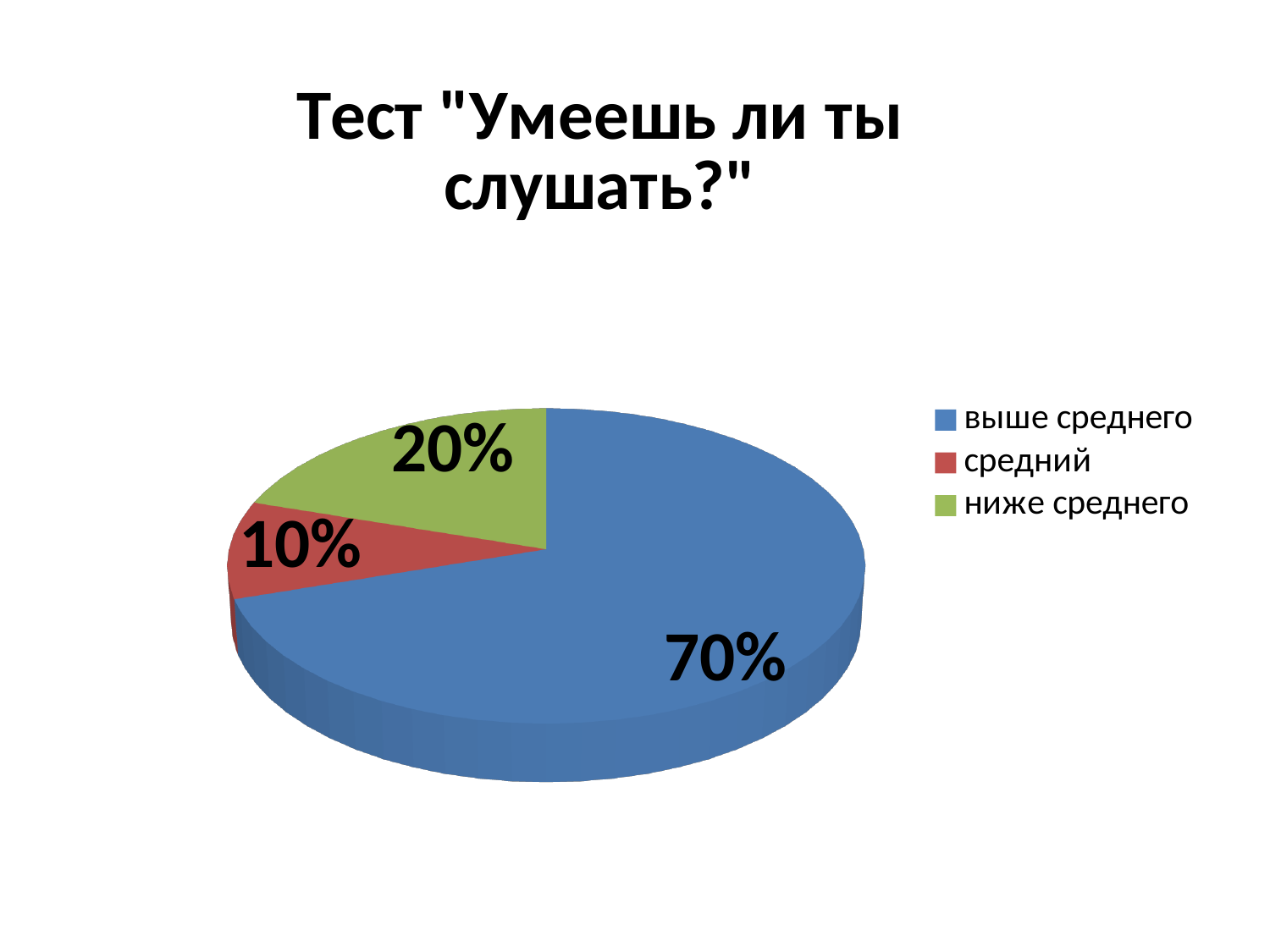
What is the difference between the shares for "ниже среднего" and "средний"? 10% Which is larger, the share for "средний" or the share for "ниже среднего"? ниже среднего Which category has the smallest slice of the pie? средний What is the title of the chart? Тест "Умеешь ли ты слушать?" What share of the pie does "средний" have? 10% What is the difference between the shares for "выше среднего" and "ниже среднего"? 50% What colour is the slice for "средний"? red Which category has the largest slice of the pie? выше среднего What kind of chart is shown on the slide? pie chart What share of the pie does "выше среднего" have? 70% What share of the pie does "ниже среднего" have? 20% How many categories are shown in the pie chart? 3